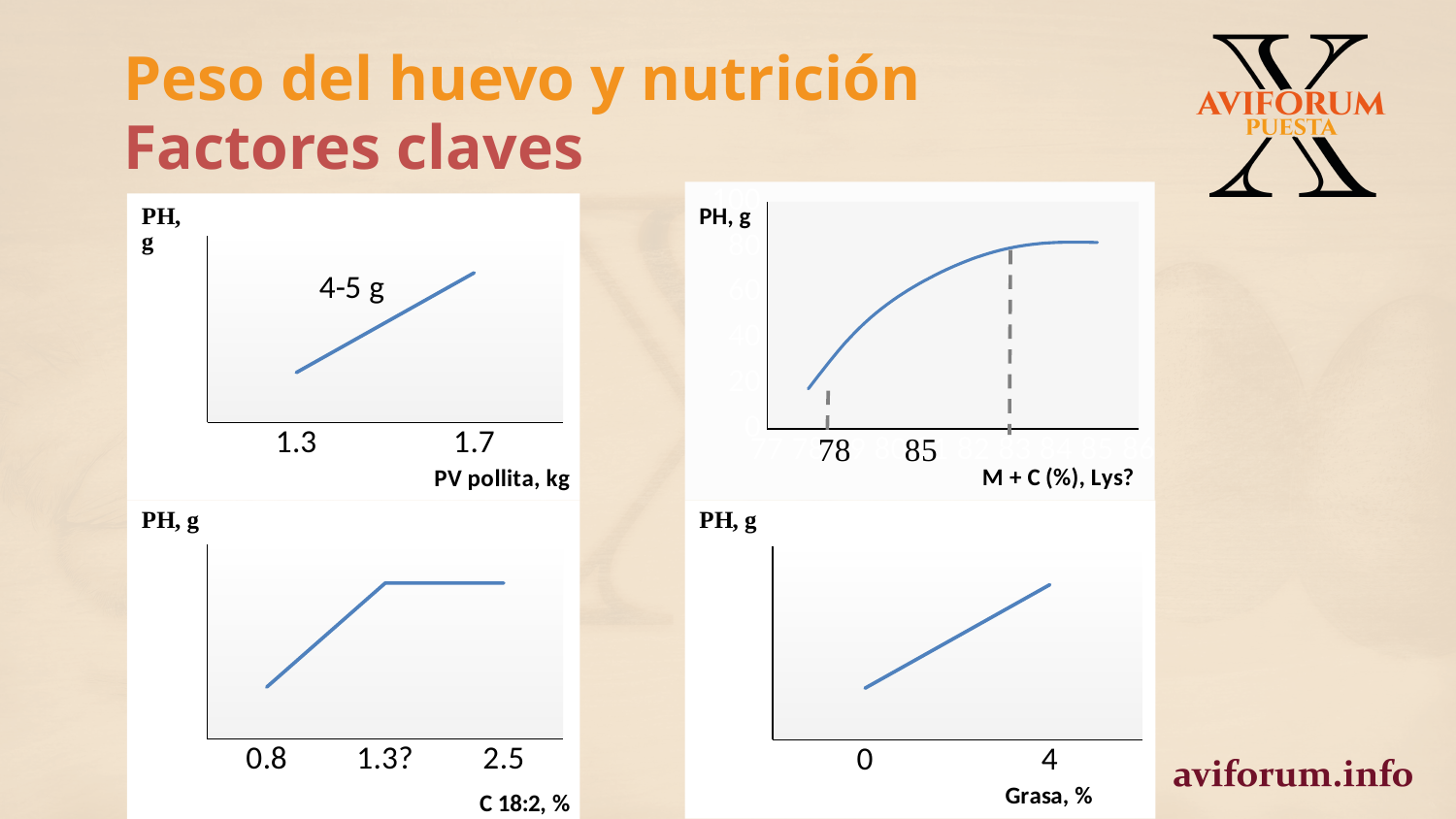
How many charts are shown on the slide? 4 What is the y-axis label shared by all four charts? PH, g In the bottom-left chart, which has the higher PH value: C 18:2 of 0.8% or 2.5%? 2.5% What is the x-axis label of the top-right chart? M + C (%), Lys? In the bottom-right chart (Grasa, %), does PH rise or fall as Grasa increases from 0 to 4%? Rises In the bottom-left chart (C 18:2, %), how many x-axis tick labels are shown? 3 In the top-left chart, does PH rise or fall as PV pollita increases from 1.3 to 1.7 kg? Rises In the top-right chart, does PH rise or fall as M + C (%) increases from 78 to 85? Rises What kind of chart is the top-left chart (PV pollita, kg)? Line chart In the top-left chart, what annotation is printed next to the line? 4-5 g In the top-left chart, which has the higher PH value: PV pollita of 1.3 kg or 1.7 kg? 1.7 kg